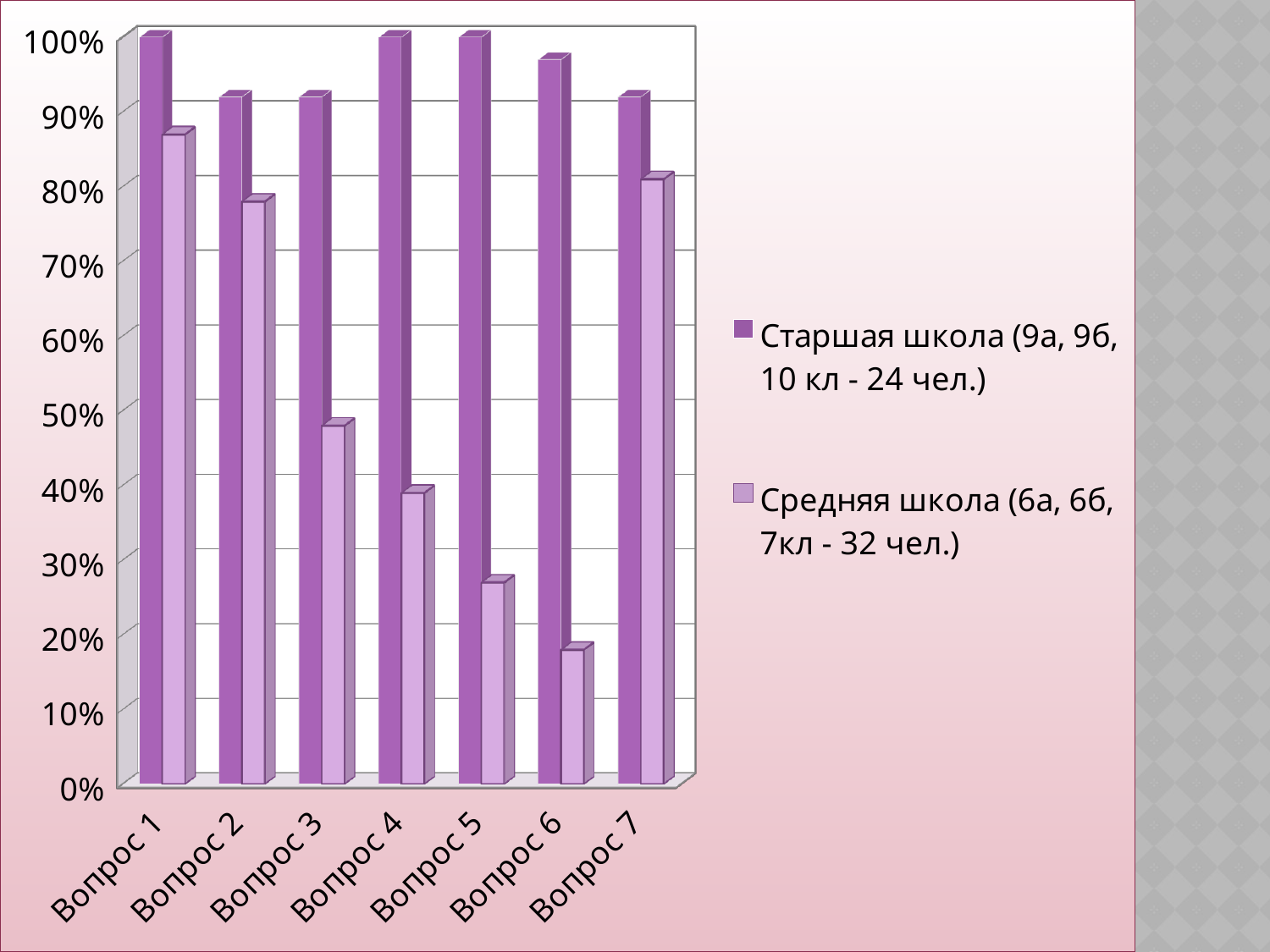
Is the value for Средняя школа at Вопрос 5 greater or less than 30%? less What kind of chart is shown on the slide? bar chart For which question is the value for Средняя школа the lowest? Вопрос 6 For which question is the value for Средняя школа the highest? Вопрос 1 How many series does the legend list? 2 Do the values for Средняя школа rise or fall from Вопрос 1 to Вопрос 6? fall Which series is shown in the lighter purple colour? Средняя школа (6а, 6б, 7кл - 32 чел.) Is the value for Старшая школа at Вопрос 6 greater or less than 90%? greater For Вопрос 3, which series has the larger value, Старшая школа or Средняя школа? Старшая школа How many categories (questions) are shown on the x axis? 7